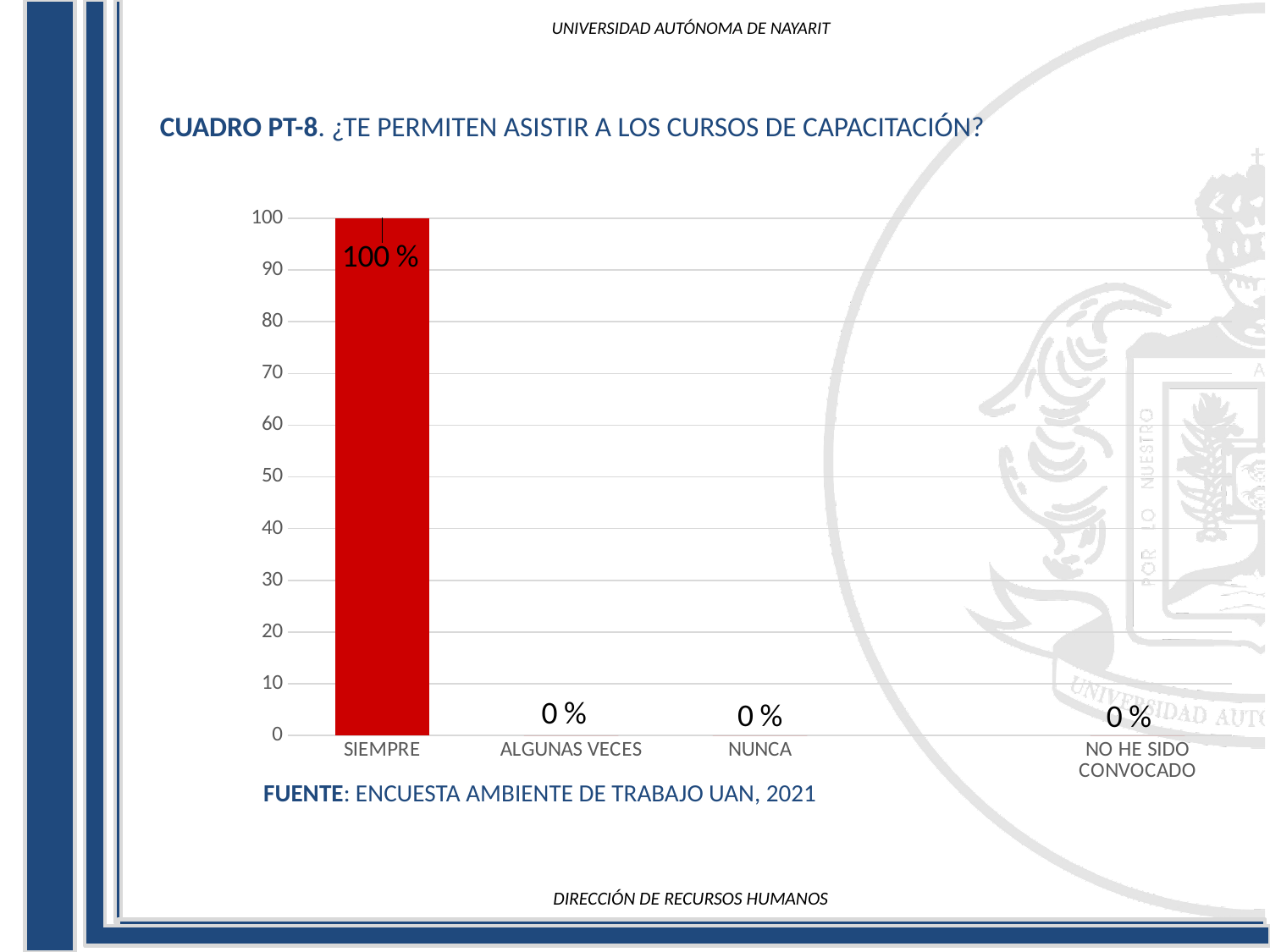
Which category has the highest value? SIEMPRE What is the title of the chart (CUADRO PT-8)? ¿TE PERMITEN ASISTIR A LOS CURSOS DE CAPACITACIÓN? Is the value for SIEMPRE greater or less than 50? greater What kind of chart is shown on the slide? bar chart Which is larger, the value for SIEMPRE or the value for ALGUNAS VECES? SIEMPRE What is the value for ALGUNAS VECES? 0 % What is the value for NUNCA? 0 % What is the value for SIEMPRE? 100 % What colour is the bar for SIEMPRE? red What is the value for NO HE SIDO CONVOCADO? 0 % How many categories are shown on the x axis? 4 What is the difference between the values for SIEMPRE and NUNCA? 100 %